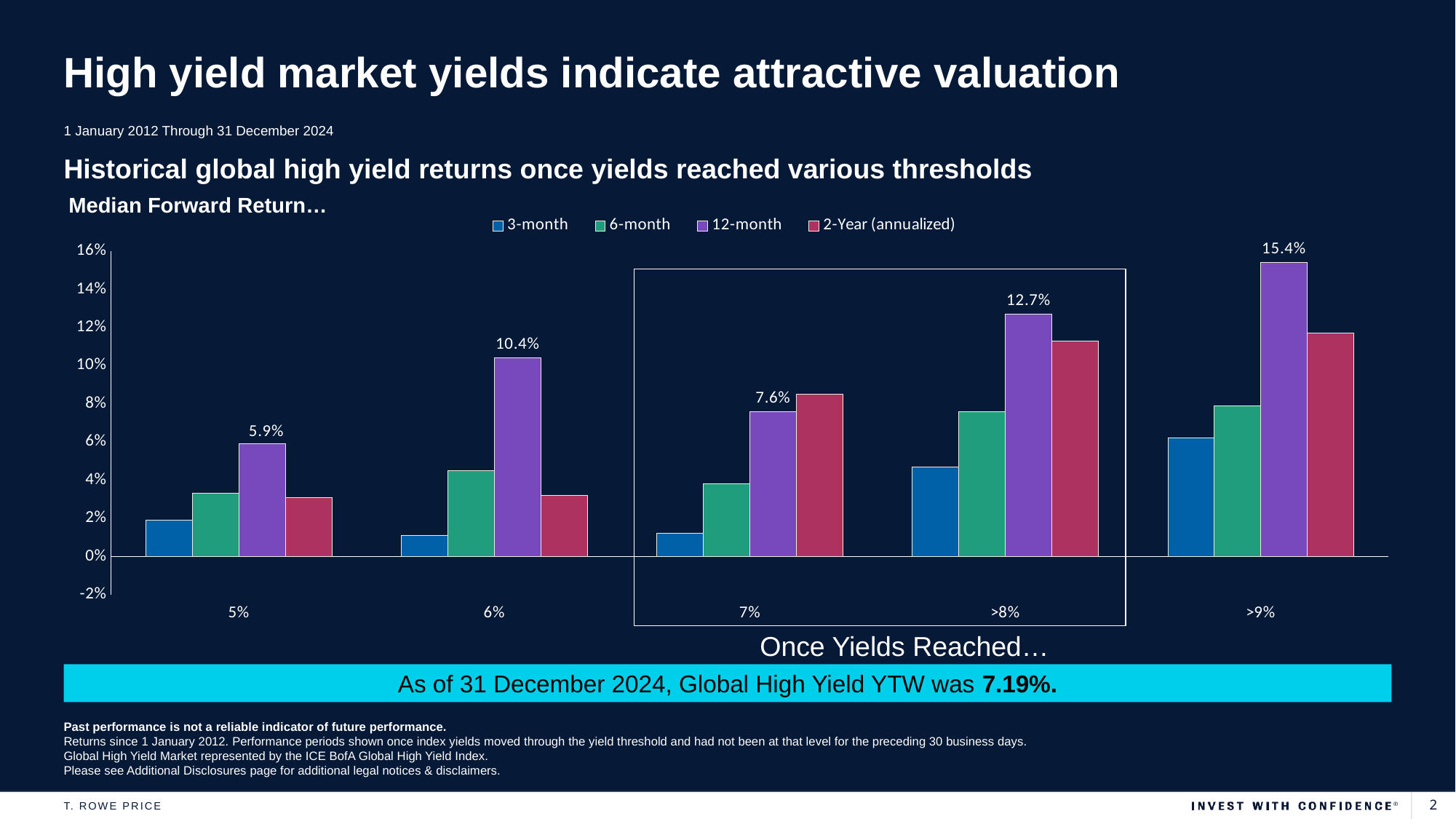
Is the 2-Year (annualized) return at >8% greater or less than 10%? greater What is the 12-month median forward return once yields reached >8%? 12.7% Which is larger: the 12-month return at 6% or at 7%? 6% What kind of chart is shown on the slide? Bar chart What is the 12-month median forward return once yields reached >9%? 15.4% What is the difference between the 12-month return at >9% and at >8%? 2.7 percentage points How many yield thresholds are shown on the x axis? 5 What is the 12-month median forward return once yields reached 5%? 5.9% For which yield threshold is the 12-month median forward return highest? >9% How many series does the legend list? 4 For which yield threshold is the 12-month median forward return lowest? 5% Is the 3-month return at 5% greater or less than 4%? less